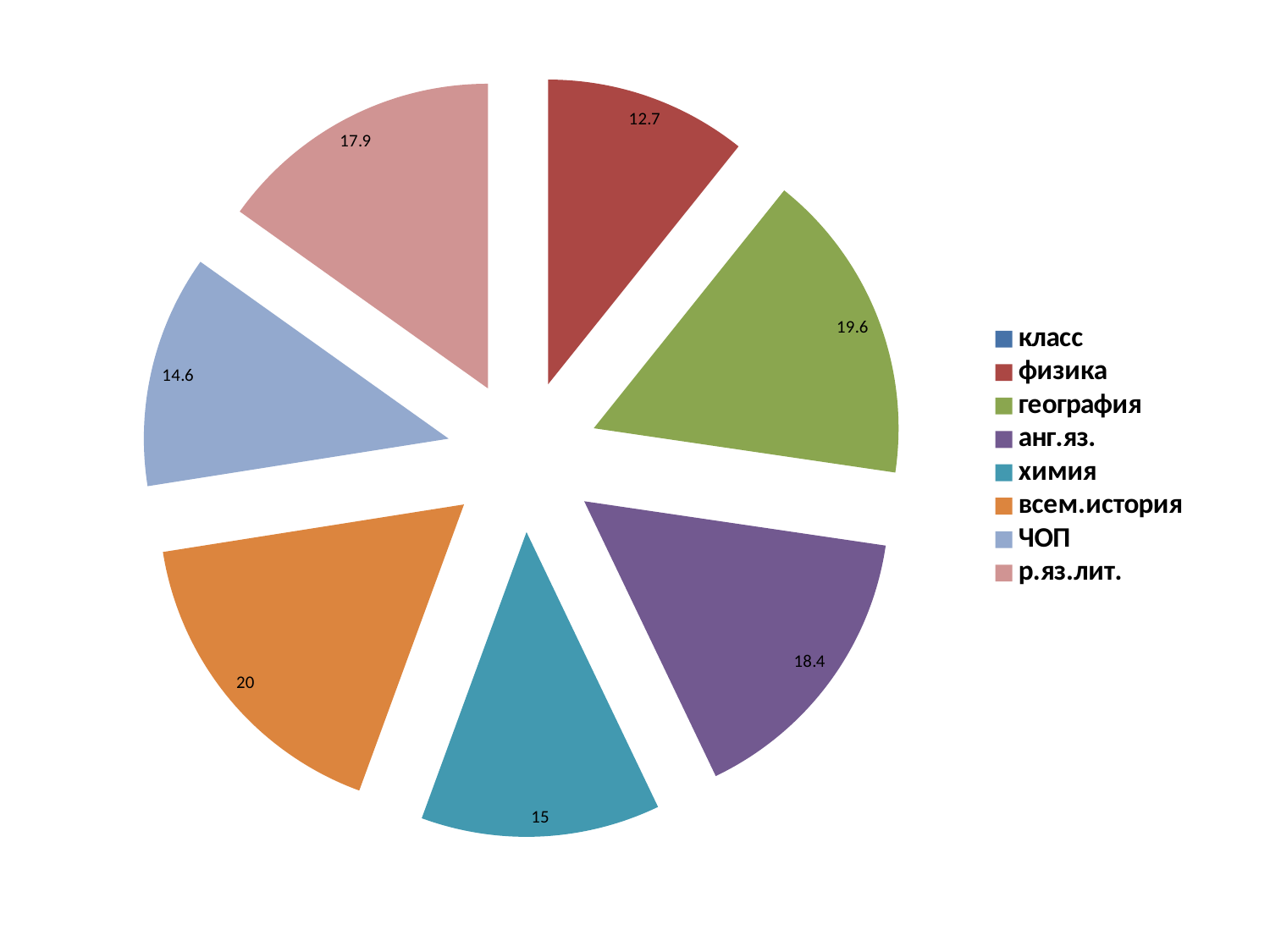
What is the value of the физика slice? 12.7 Which category has the largest slice? всем.история How many entries does the legend list? 8 What type of chart is shown on the slide? pie chart What is the difference between the р.яз.лит. value and the ЧОП value? 3.3 What is the value of the всем.история slice? 20 What is the value of the география slice? 19.6 Which is larger, the география slice or the анг.яз. slice? география Which category has the smallest slice? физика How many slices are plotted in the pie chart? 7 What is the difference between the всем.история value and the физика value? 7.3 What is the value of the ЧОП slice? 14.6